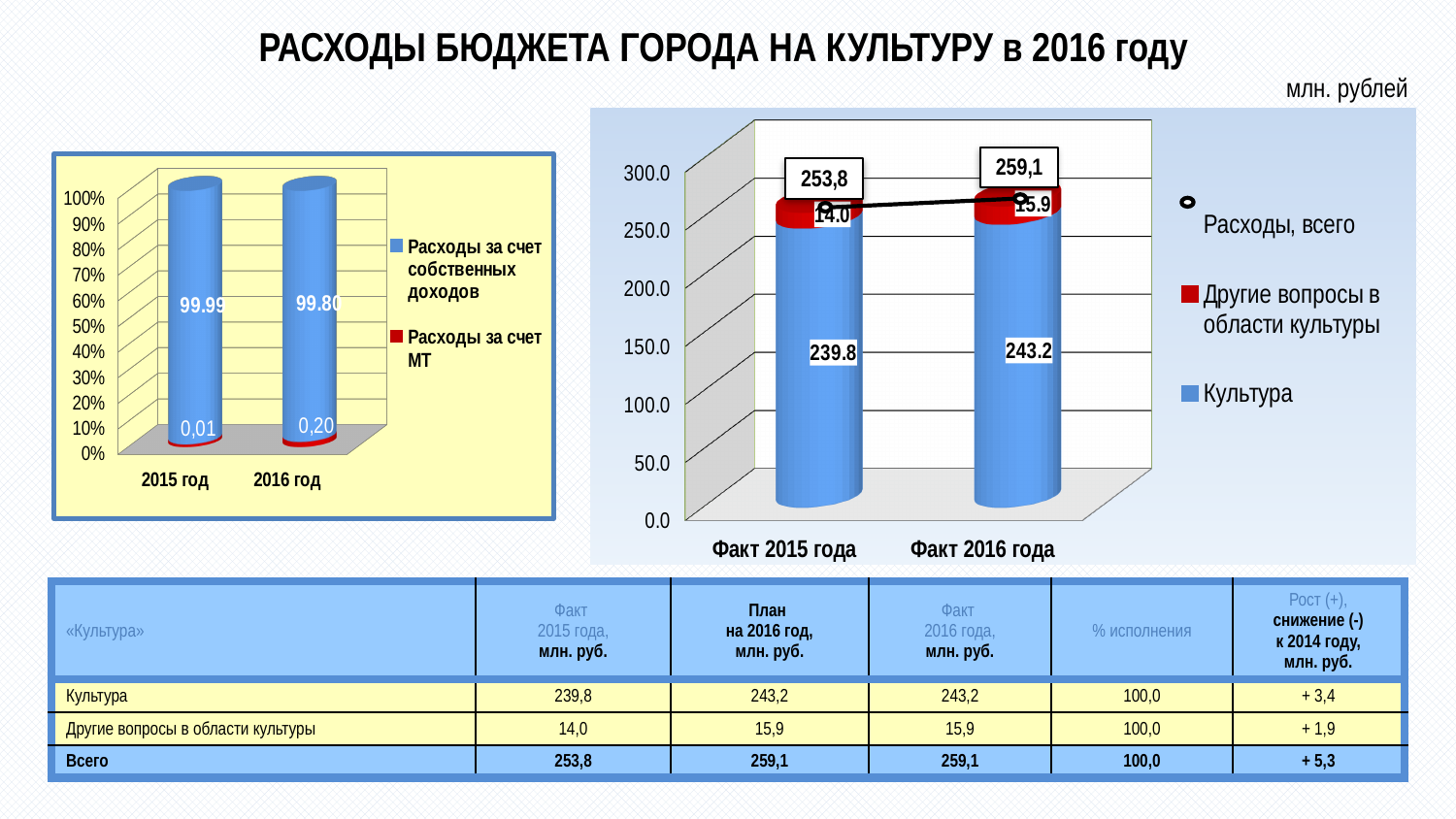
In the right chart, is the Культура value for Факт 2015 года greater or less than 200.0? greater How many categories are shown on the x axis of the left chart? 2 How many series does the legend of the right chart list? 3 In the right chart, what is the difference between the Культура values for Факт 2016 года and Факт 2015 года? 3.4 In the left chart, what is the value for Расходы за счет МТ for 2015 год? 0,01 What kind of chart is the left chart? Stacked bar chart In the right chart, which category has the larger value for Другие вопросы в области культуры, Факт 2015 года or Факт 2016 года? Факт 2016 года In the right chart, what is the value for Другие вопросы в области культуры for Факт 2015 года? 14.0 In the left chart, which year has the larger value for Расходы за счет МТ? 2016 год In the right chart, what is the total (Расходы, всего) shown for Факт 2016 года? 259,1 In the left chart, what is the value for Расходы за счет собственных доходов for 2016 год? 99.80 In the right chart, what is the value for Культура for Факт 2016 года? 243.2